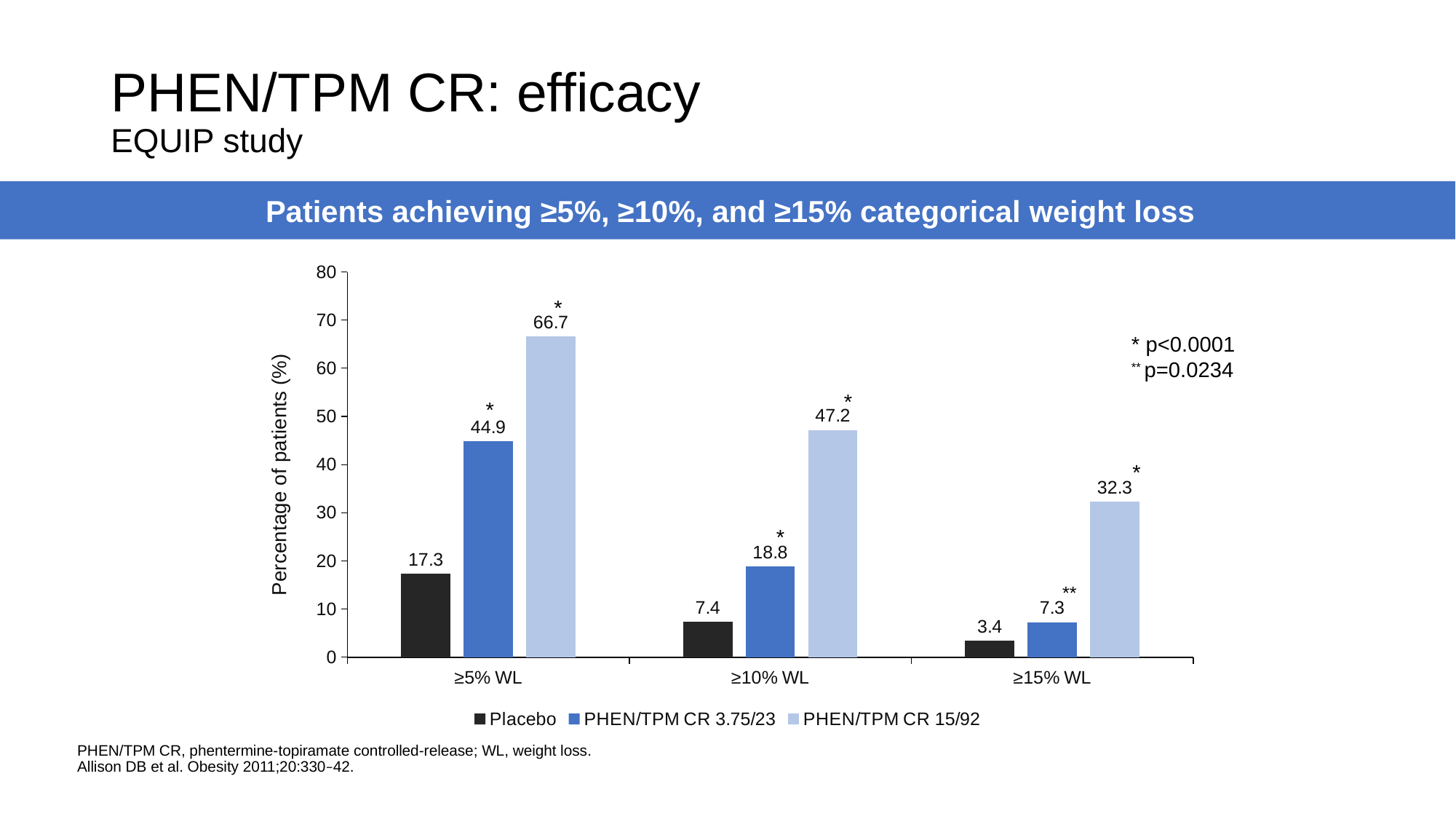
What is the label of the y axis? Percentage of patients (%) What is the difference between PHEN/TPM CR 15/92 and Placebo in the ≥5% WL category? 49.4 Which treatment group has the highest percentage of patients achieving ≥10% WL? PHEN/TPM CR 15/92 How many series does the legend list? 3 What is the value for PHEN/TPM CR 3.75/23 in the ≥15% WL category? 7.3 Which is larger: PHEN/TPM CR 3.75/23 at ≥5% WL or PHEN/TPM CR 15/92 at ≥15% WL? PHEN/TPM CR 3.75/23 at ≥5% WL Which treatment group has the lowest percentage of patients achieving ≥15% WL? Placebo What kind of chart is shown on the slide? Bar chart What percentage of patients on PHEN/TPM CR 15/92 achieved ≥5% WL? 66.7 What is the value for Placebo in the ≥10% WL category? 7.4 How many weight-loss categories are shown on the x axis? 3 Is the value for PHEN/TPM CR 15/92 at ≥10% WL greater or less than 40? greater